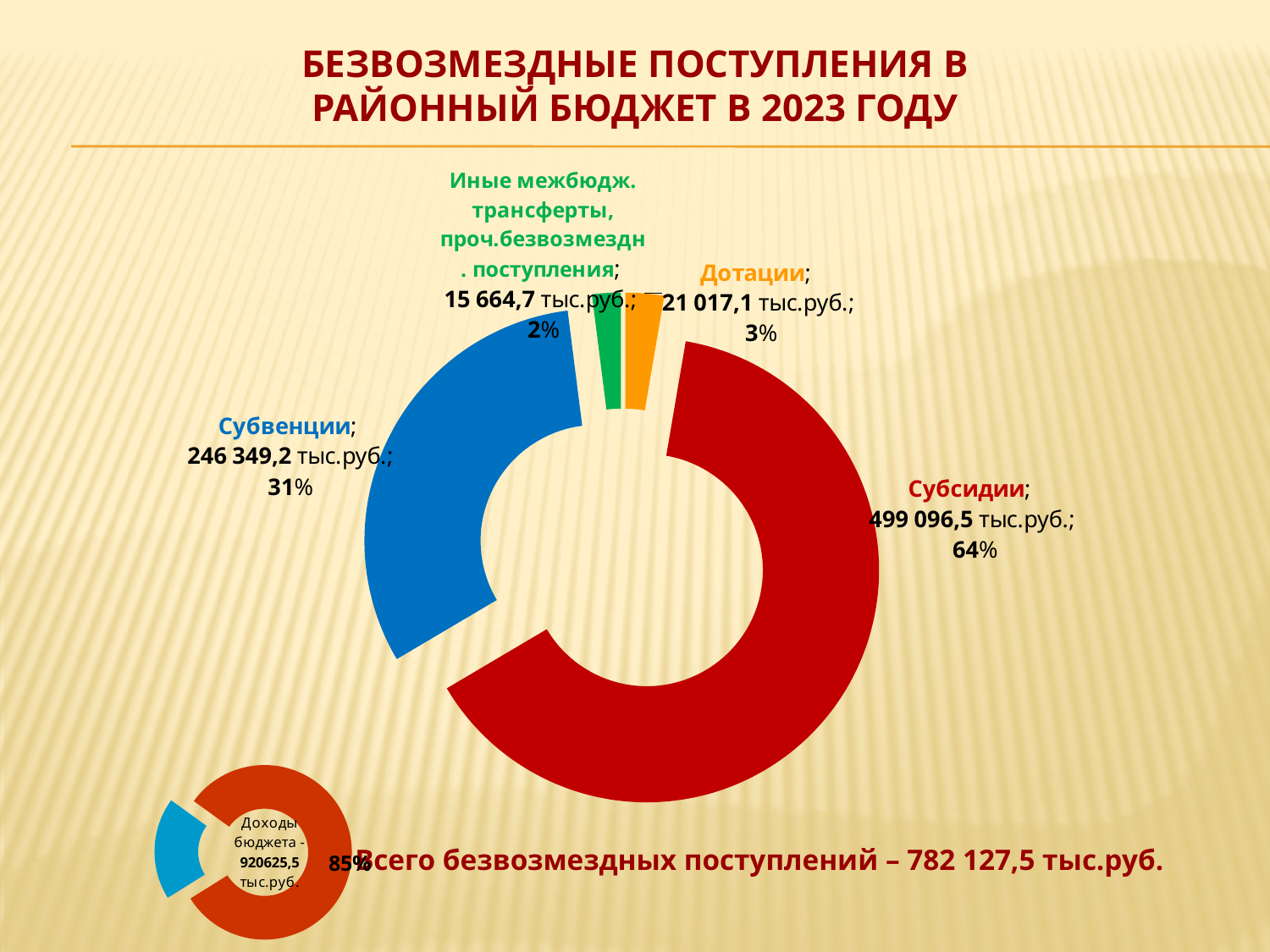
On the large doughnut chart, what is the value for Субсидии? 499 096,5 тыс.руб. On the large doughnut chart, what is the value for Субвенции? 246 349,2 тыс.руб. On the small doughnut chart at the bottom left, what value is shown for Доходы бюджета? 920625,5 тыс.руб. On the large doughnut chart, what percentage share is shown for Субсидии? 64% On the large doughnut chart, which category has the largest value? Субсидии How many categories are shown on the large doughnut chart? 4 On the large doughnut chart, what percentage share is shown for Иные межбюдж. трансферты, проч.безвозмездн. поступления? 2% On the large doughnut chart, which category has the smallest value? Иные межбюдж. трансферты, проч.безвозмездн. поступления On the large doughnut chart, what is the value for Дотации? 21 017,1 тыс.руб. On the large doughnut chart, which is larger: Субвенции or Дотации? Субвенции On the large doughnut chart, what is the difference in percentage share between Субсидии and Субвенции? 33% What type of chart is the large chart on the slide? Doughnut chart